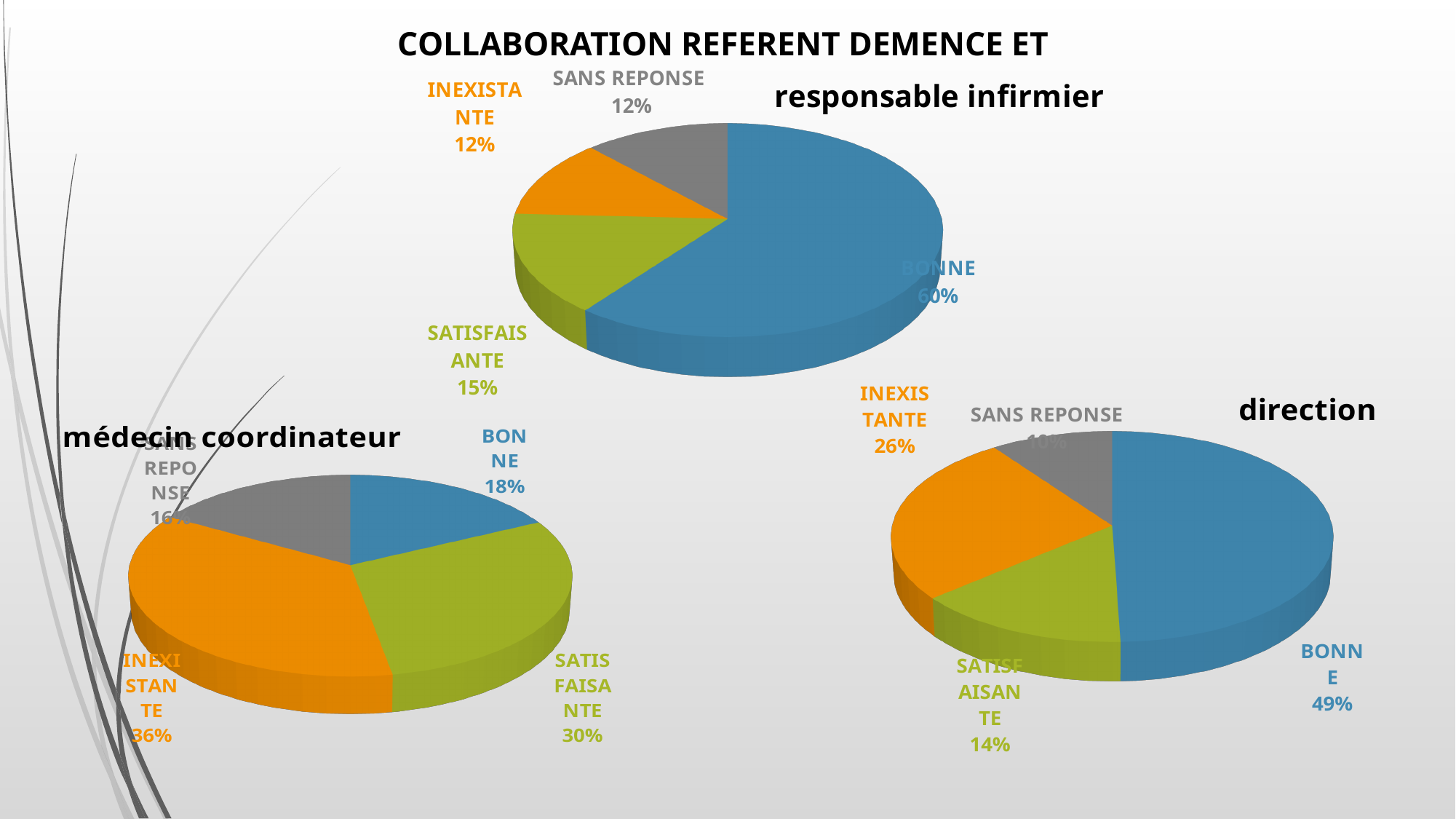
In the 'responsable infirmier' pie chart, what share is labelled SATISFAISANTE? 15% In the 'responsable infirmier' pie chart, what share is labelled BONNE? 60% In the 'médecin coordinateur' pie chart, what share is labelled BONNE? 18% In the 'direction' pie chart, what share is labelled INEXISTANTE? 26% What type of chart is used for 'direction'? Pie chart In the 'direction' pie chart, which is larger: the INEXISTANTE share or the SATISFAISANTE share? INEXISTANTE In the 'médecin coordinateur' pie chart, which category has the largest share? INEXISTANTE How many slices does the 'médecin coordinateur' pie chart have? 4 In the 'responsable infirmier' pie chart, what is the difference between the BONNE share and the SATISFAISANTE share? 45% In the 'direction' pie chart, which category has the smallest share? SANS REPONSE In the 'direction' pie chart, what share is labelled BONNE? 49% In the 'médecin coordinateur' pie chart, what share is labelled INEXISTANTE? 36%